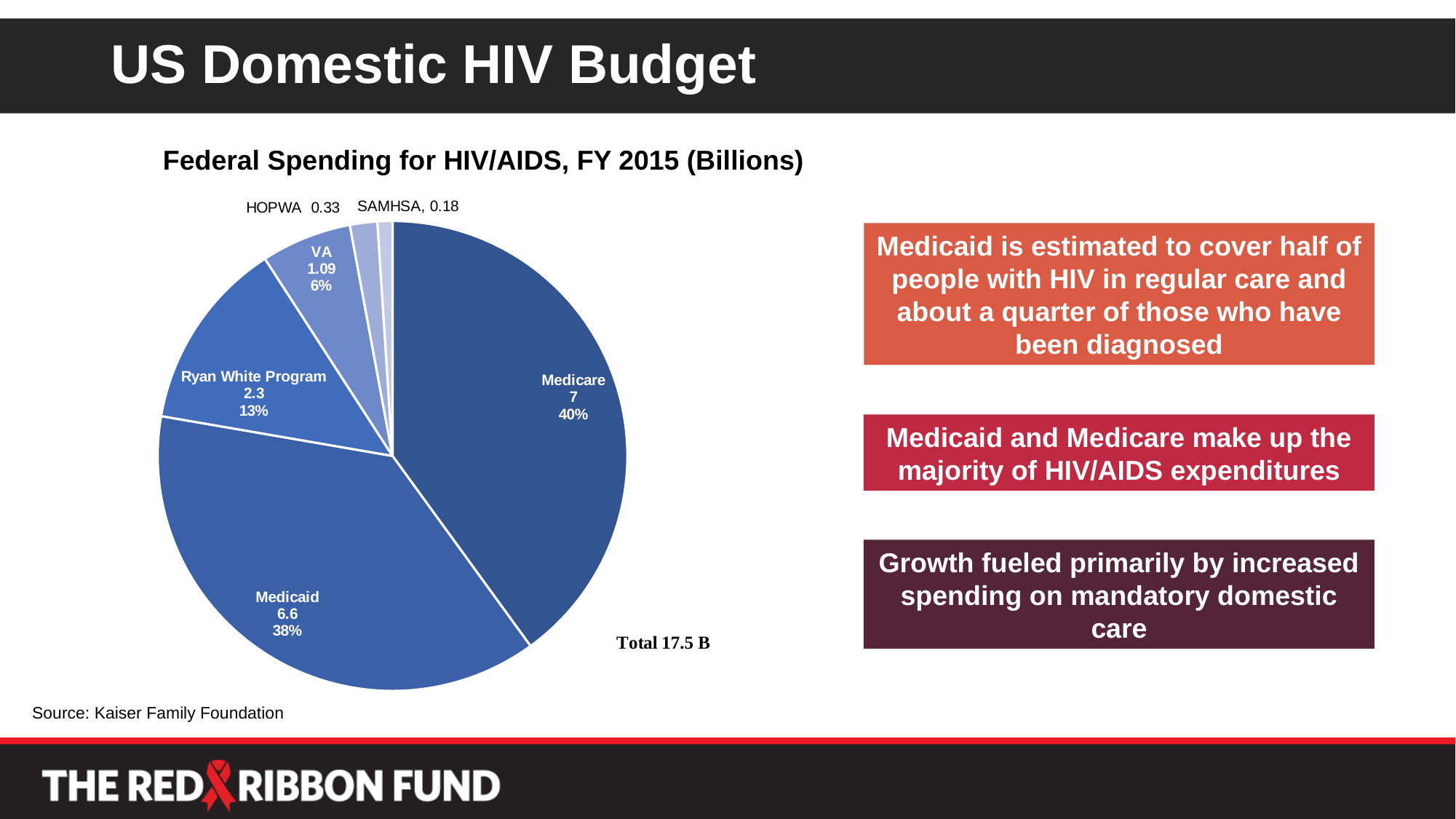
What is the value for the Ryan White Program? 2.3 What is the difference between the Medicare and Medicaid values? 0.4 What share of the pie does Medicaid represent? 38% What is the value for Medicare? 7 What is the title of the chart? Federal Spending for HIV/AIDS, FY 2015 (Billions) What type of chart is shown on the slide? Pie chart Which category has the largest slice of the pie? Medicare What is the value for HOPWA? 0.33 Which category has the smallest slice of the pie? SAMHSA How many categories are shown in the pie chart? 6 What is the value for Medicaid? 6.6 Which is larger, the value for VA or the value for the Ryan White Program? Ryan White Program